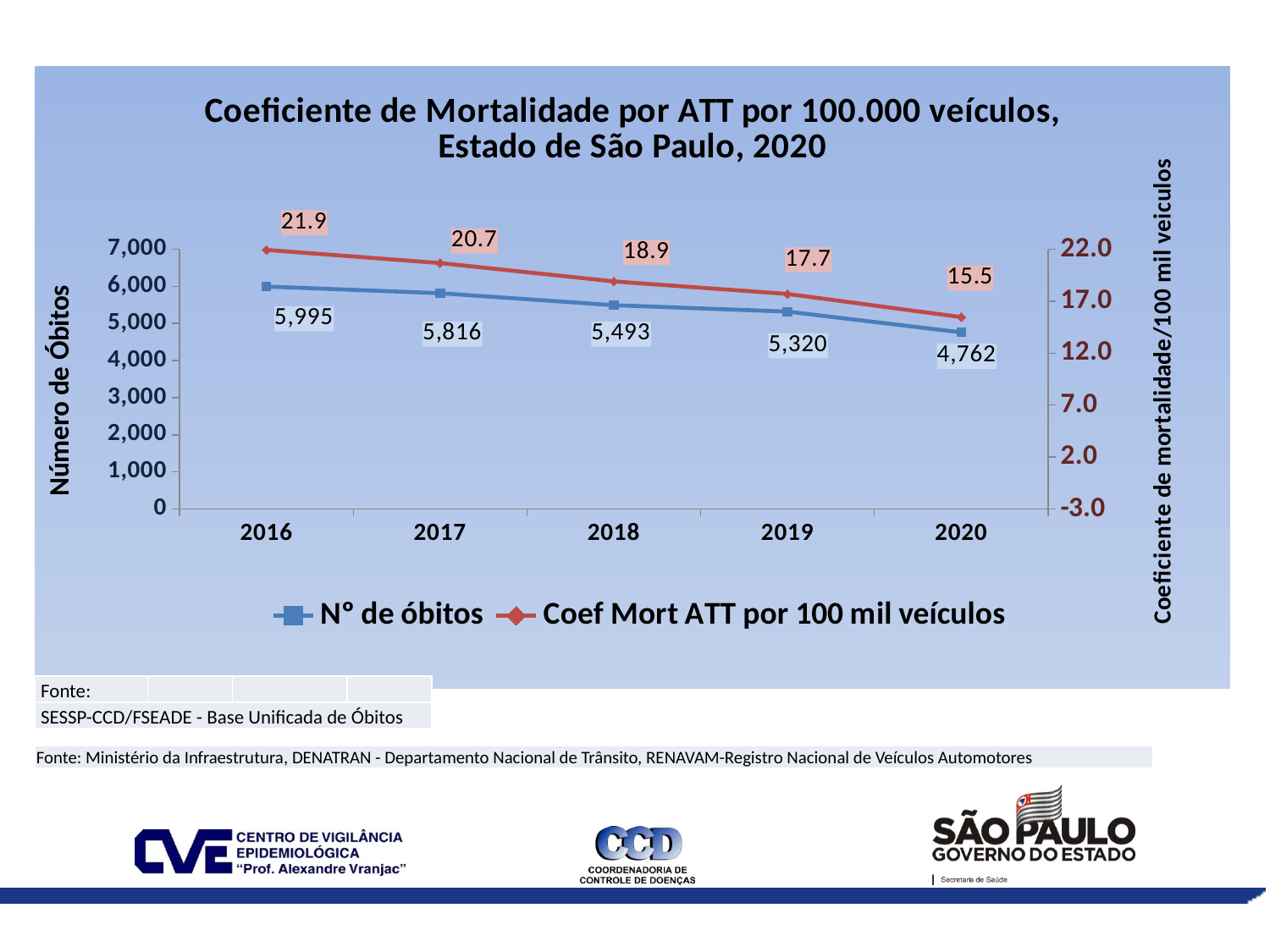
What is the number of deaths (N° de óbitos) in 2018? 5,493 Is the number of deaths higher in 2017 or in 2019? 2017 What is the number of deaths (N° de óbitos) in 2016? 5,995 What is the value of Coef Mort ATT por 100 mil veículos in 2017? 20.7 What kind of chart is this? Line chart How many years are shown on the x axis? 5 Which year has the highest number of deaths (N° de óbitos)? 2016 What is the value of Coef Mort ATT por 100 mil veículos in 2020? 15.5 Which year has the lowest Coef Mort ATT por 100 mil veículos? 2020 What is the difference in Coef Mort ATT por 100 mil veículos between 2018 and 2019? 1.2 How many series does the legend list? 2 What is the difference in the number of deaths between 2016 and 2020? 1,233